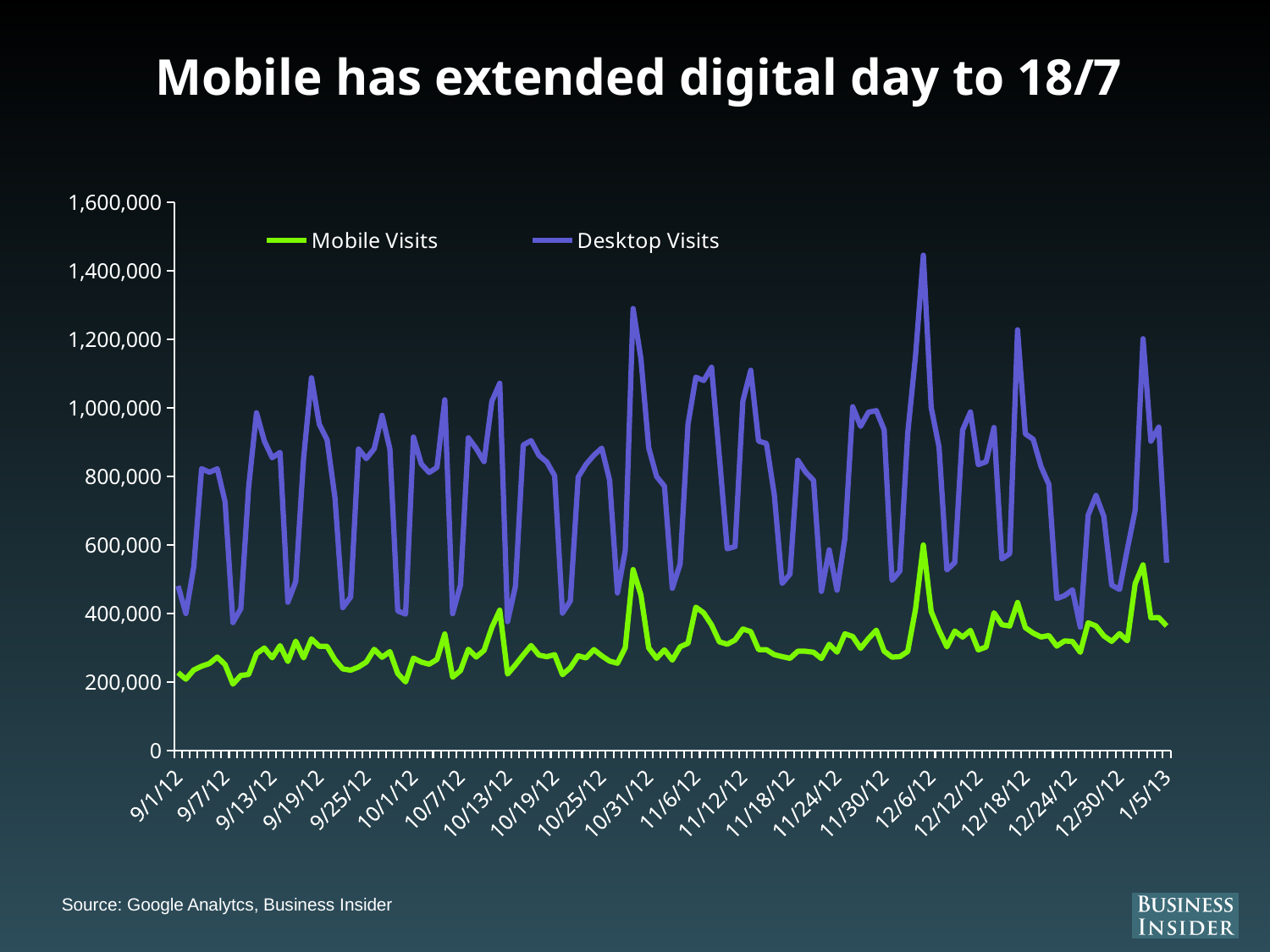
What is the last date label on the x axis? 1/5/13 Is the highest value of Desktop Visits greater or less than 1,400,000? greater Is the value of Desktop Visits on 9/1/12 greater or less than 600,000? less Do Mobile Visits generally rise or fall from 9/1/12 to 1/5/13? Rise Is the value of Mobile Visits on 9/1/12 greater or less than 400,000? less What is the title of the chart? Mobile has extended digital day to 18/7 What is the maximum value shown on the y axis? 1,600,000 What kind of chart is shown on the slide? Line chart Which series has higher values throughout the period, Mobile Visits or Desktop Visits? Desktop Visits How many series does the legend list? 2 Which colour is used for the Mobile Visits line? Green